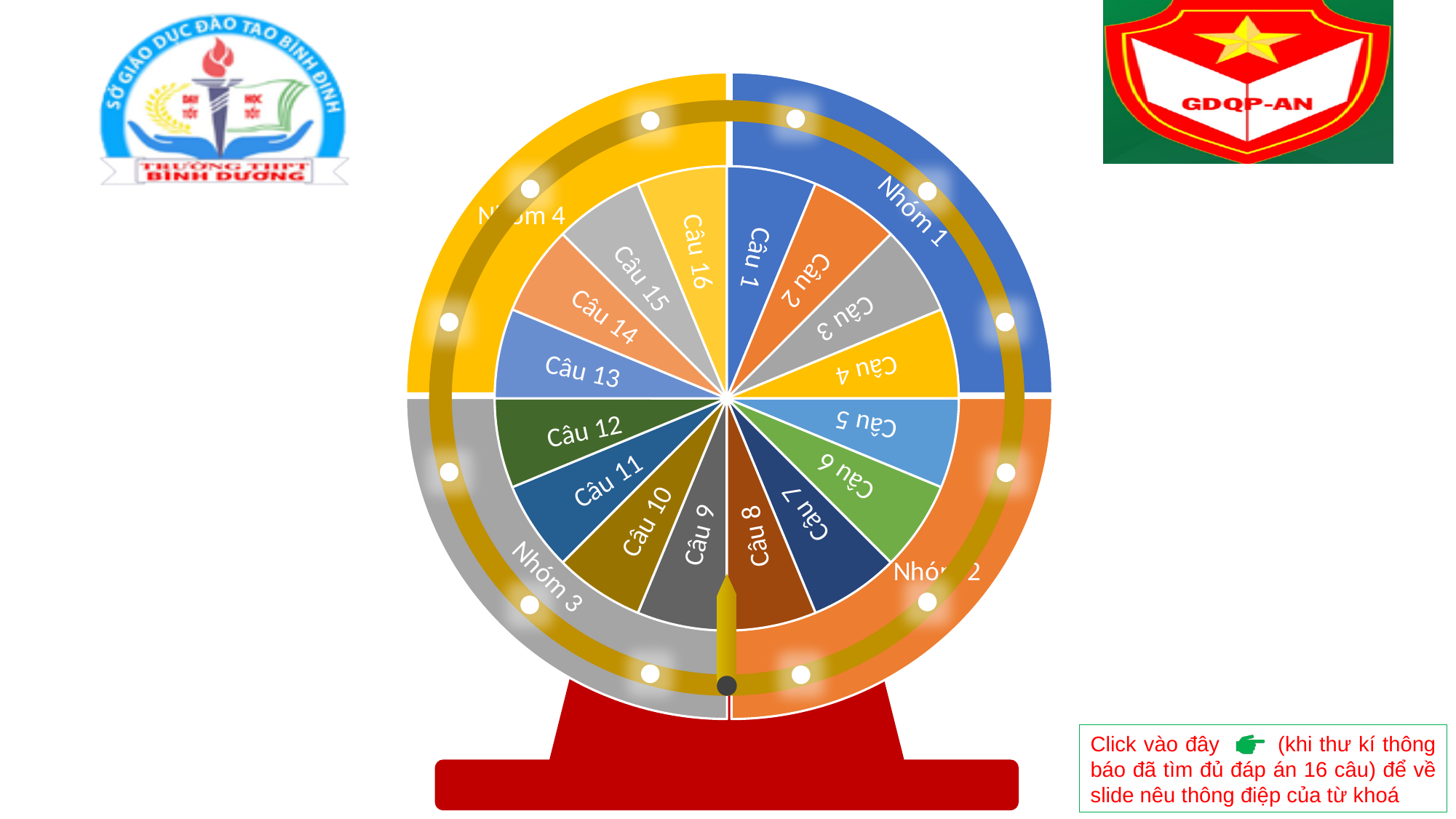
What colour is the outer ring segment labelled Nhóm 4? yellow What kind of chart is used to make the inner wheel of questions? pie chart Which group label appears in the top-right segment of the outer ring? Nhóm 1 What is the label of the last slice of the inner wheel, just left of the top? Câu 16 Which slice lies between Câu 1 and Câu 3 on the inner wheel? Câu 2 How many question slices (Câu) does the inner wheel contain? 16 What is the label of the first slice clockwise from the top of the inner wheel? Câu 1 How many group segments (Nhóm) does the outer ring of the wheel contain? 4